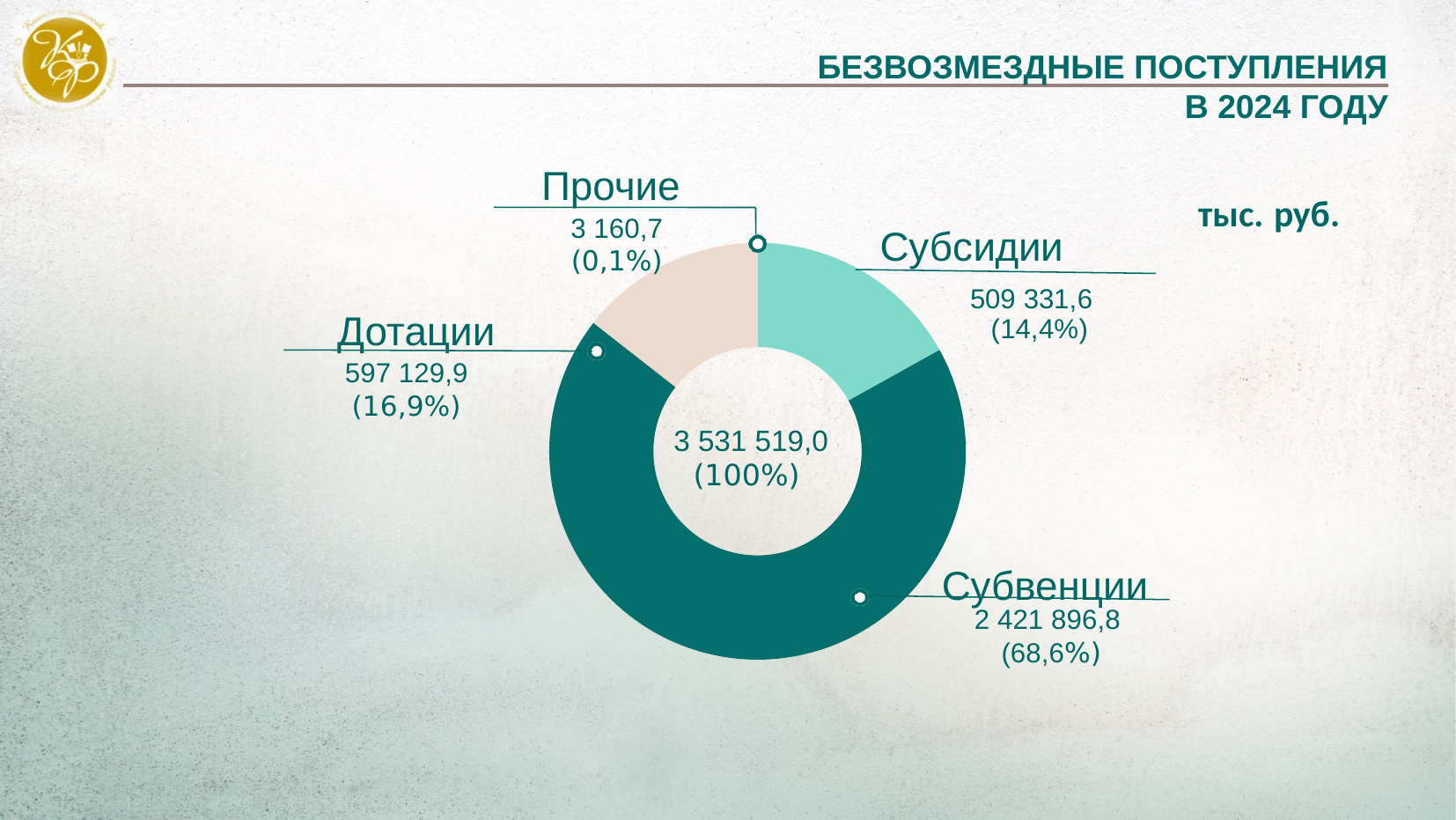
What is the value for Прочие? 3 160,7 What is the value for Субвенции? 2 421 896,8 What type of chart is shown on the slide? Donut (pie) chart What share of the total do Дотации make up? 16,9% What is the value for Субсидии? 509 331,6 How many categories are shown in the chart? 4 What is the value for Дотации? 597 129,9 Which category has the largest value? Субвенции Which is larger, Дотации or Субсидии? Дотации Which category has the smallest value? Прочие What is the total shown in the centre of the chart? 3 531 519,0 What share of the total do Субвенции make up? 68,6%